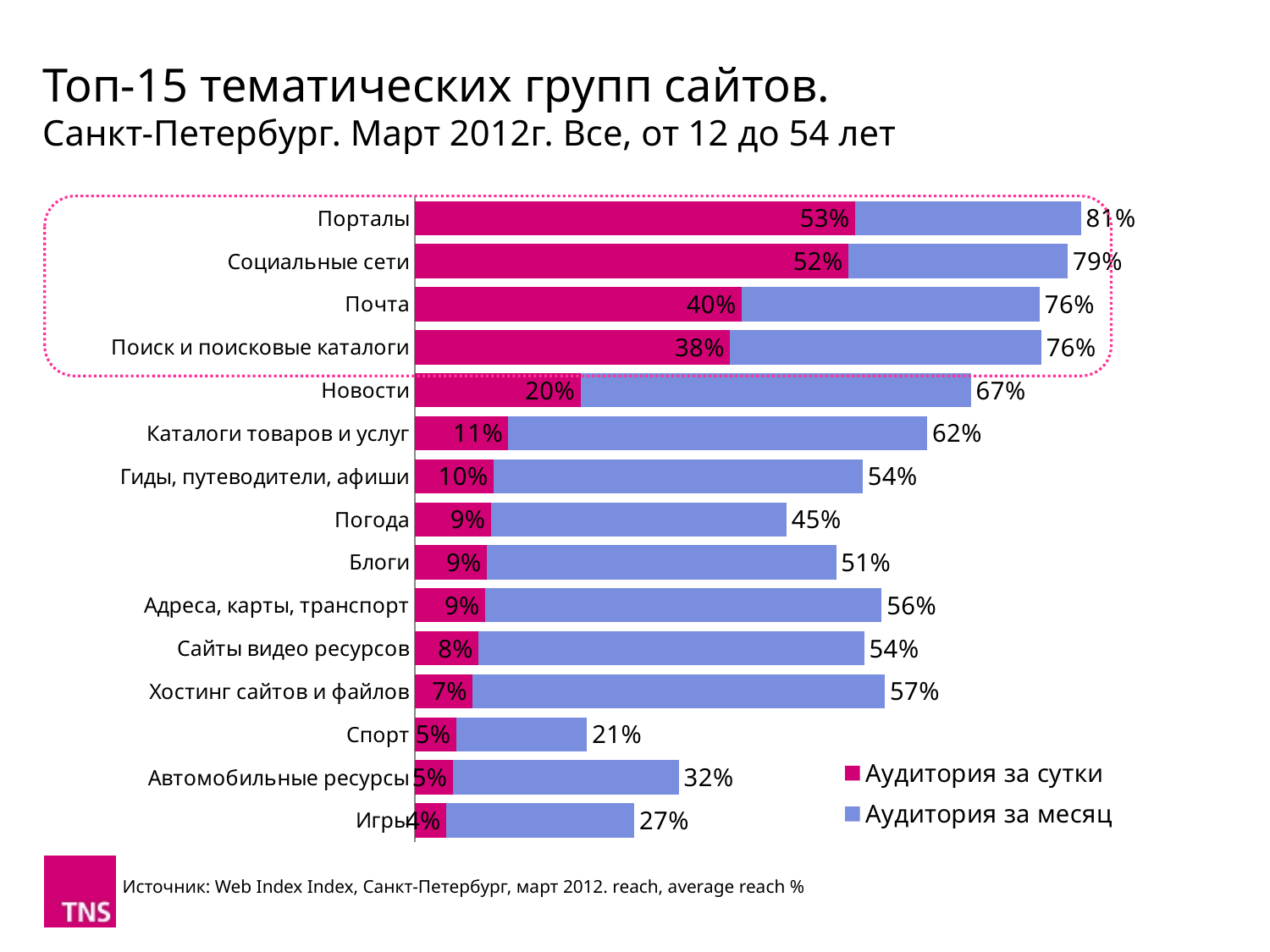
What is the value of "Аудитория за сутки" for Порталы? 53% How many series does the legend list? 2 What is the difference in "Аудитория за месяц" between Порталы and Социальные сети? 2% How many categories are shown in the chart? 15 Which series is shown in pink/magenta in the legend? Аудитория за сутки What is the value of "Аудитория за месяц" for Спорт? 21% What is the difference between the "Аудитория за месяц" and "Аудитория за сутки" values for Почта? 36% Which category has the lowest "Аудитория за сутки" value? Игры Which category has the highest "Аудитория за месяц" value? Порталы What is the value of "Аудитория за месяц" for Новости? 67% What type of chart is shown on the slide? Bar chart Which has a larger "Аудитория за месяц" value: Погода or Блоги? Блоги